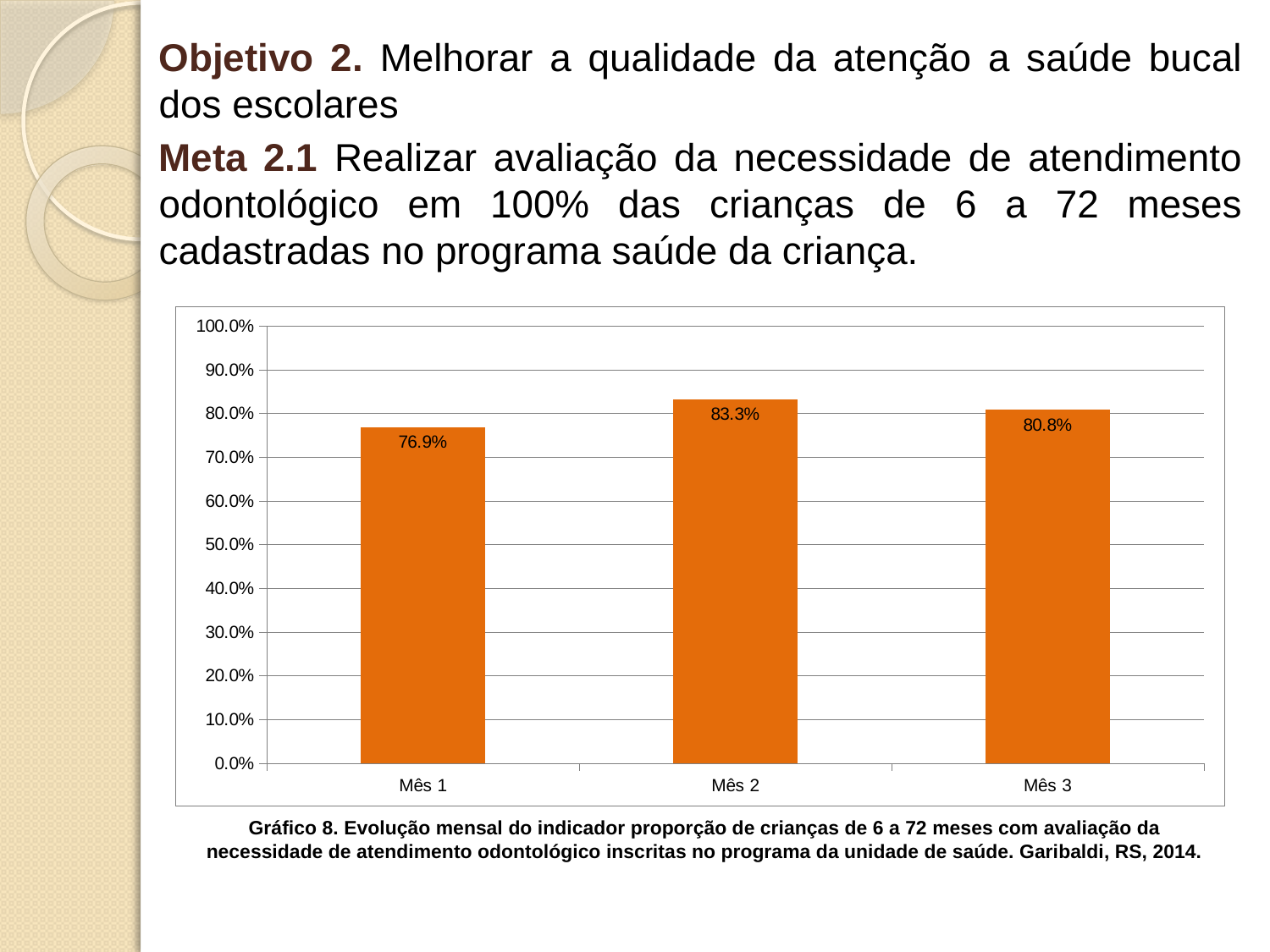
What is the value for Mês 3? 80.8% What is the value for Mês 1? 76.9% What kind of chart is shown on the slide? bar chart Which month has the highest value? Mês 2 What is the difference between the values for Mês 2 and Mês 1? 6.4% Which is larger, the value for Mês 3 or the value for Mês 1? Mês 3 How many months are shown on the x axis? 3 Which month has the lowest value? Mês 1 What is the value for Mês 2? 83.3% Is the value for Mês 1 greater or less than 80.0%? less What is the difference between the values for Mês 2 and Mês 3? 2.5% What colour are the bars in the chart? orange